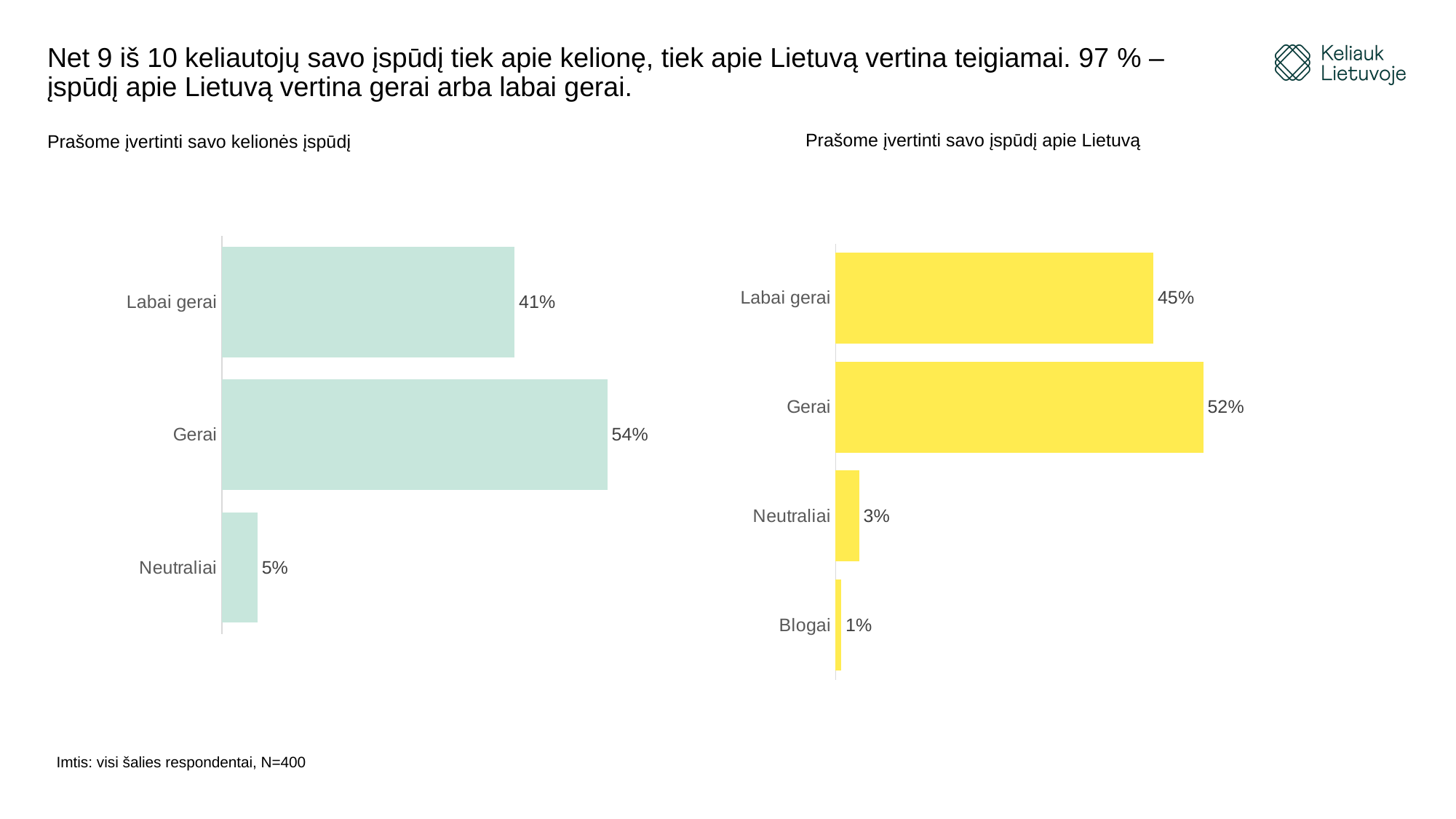
In the right chart (Prašome įvertinti savo įspūdį apie Lietuvą), which category has the lowest value? Blogai In the left chart (Prašome įvertinti savo kelionės įspūdį), what is the value for Gerai? 54% In the right chart (Prašome įvertinti savo įspūdį apie Lietuvą), what is the value for Labai gerai? 45% In the left chart (Prašome įvertinti savo kelionės įspūdį), which category has the highest value? Gerai How many categories does the right chart (Prašome įvertinti savo įspūdį apie Lietuvą) show? 4 How many categories does the left chart (Prašome įvertinti savo kelionės įspūdį) show? 3 In the right chart (Prašome įvertinti savo įspūdį apie Lietuvą), what is the value for Blogai? 1% In the left chart (Prašome įvertinti savo kelionės įspūdį), what is the difference between Gerai and Labai gerai? 13% In the left chart (Prašome įvertinti savo kelionės įspūdį), what is the value for Neutraliai? 5% Which is larger: Labai gerai in the left chart or Labai gerai in the right chart? Labai gerai in the right chart What type of chart is the left chart (Prašome įvertinti savo kelionės įspūdį)? Bar chart In the right chart (Prašome įvertinti savo įspūdį apie Lietuvą), what is the difference between Gerai and Neutraliai? 49%